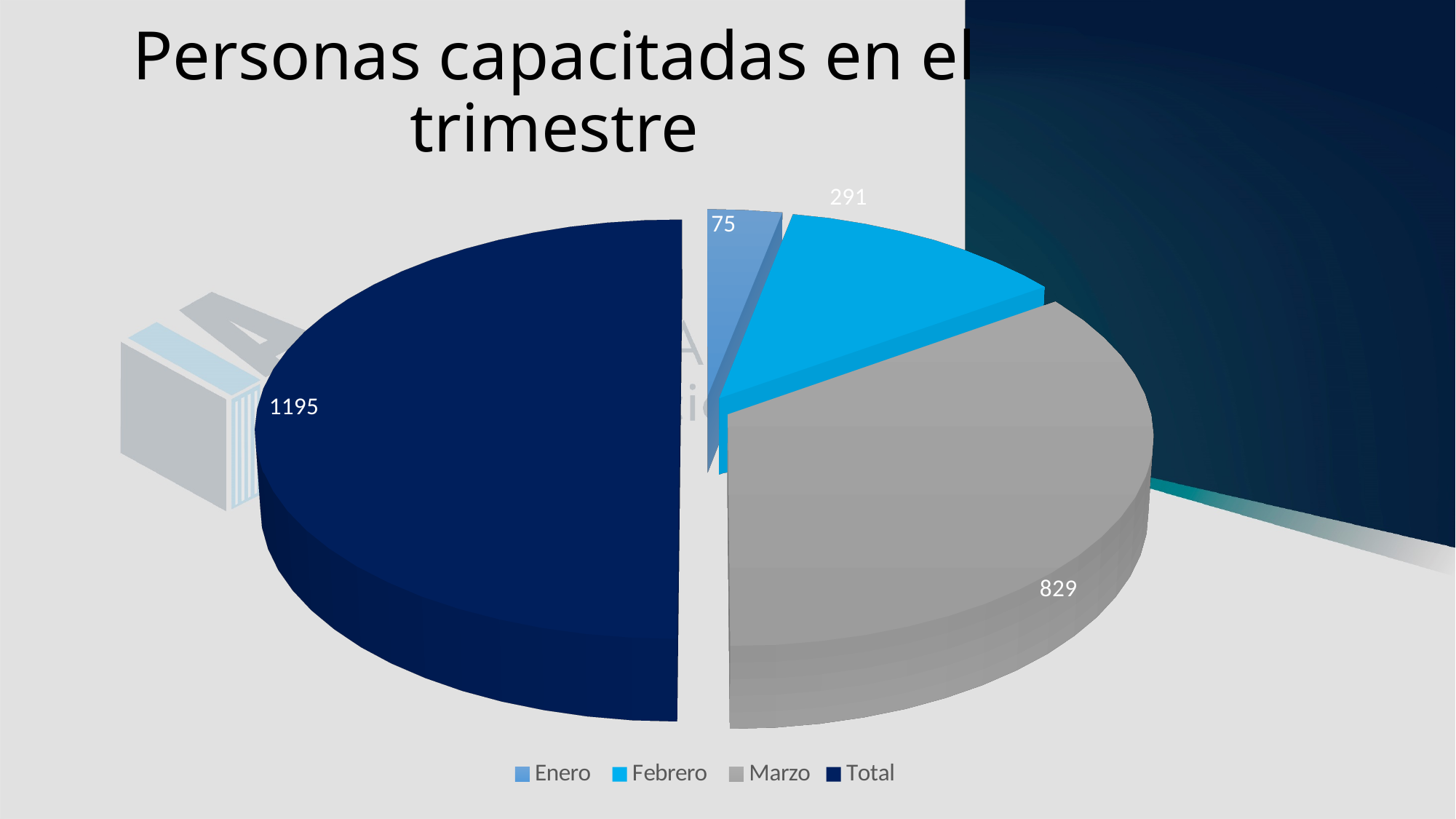
What is the value for Enero? 75 Which slice has the smallest value? Enero What is the title of the chart? Personas capacitadas en el trimestre How many entries does the legend list? 4 What is the value for Total? 1195 What is the value for Marzo? 829 What share of the pie does the Total slice represent? 50% What is the difference between the values for Marzo and Febrero? 538 What type of chart is shown on the slide? pie chart Which is larger, the value for Febrero or the value for Enero? Febrero Which slice has the largest value? Total What is the value for Febrero? 291